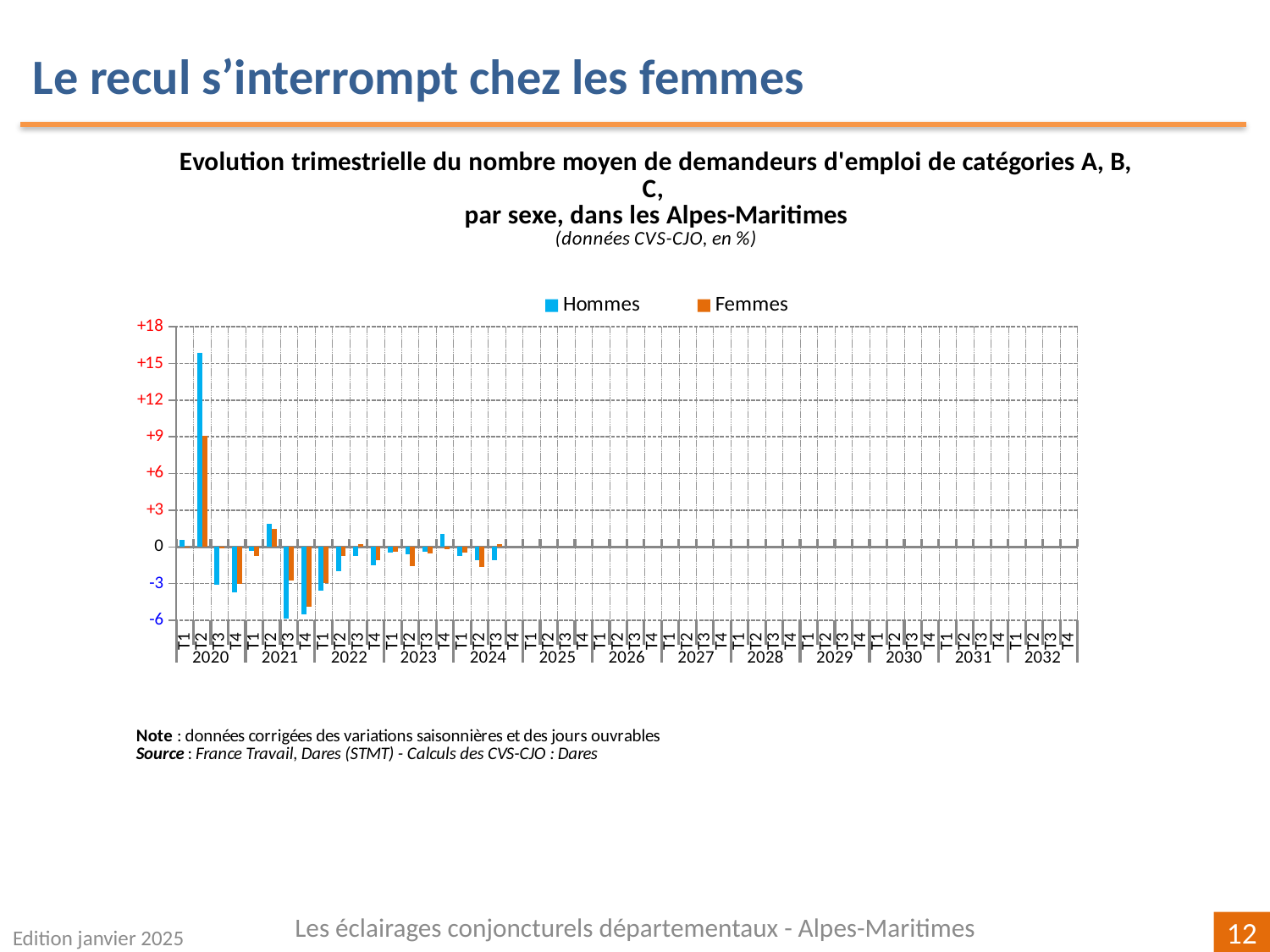
In which quarter is the Femmes value lowest? T4 2021 Which two series are shown in the legend? Hommes and Femmes What colour represents the Femmes series? orange Is the Hommes value for T2 2020 greater or less than +12? greater Is the Hommes value for T3 2021 greater or less than -3? less In T2 2020, which series has the larger value, Hommes or Femmes? Hommes In which quarter is the Femmes value highest? T2 2020 Between T2 2020 and T3 2020, does the Hommes value rise or fall? fall Is the Femmes value for T2 2020 greater or less than +6? greater In which quarter is the Hommes value highest? T2 2020 How many series does the legend list? 2 What kind of chart is shown on the slide? bar chart